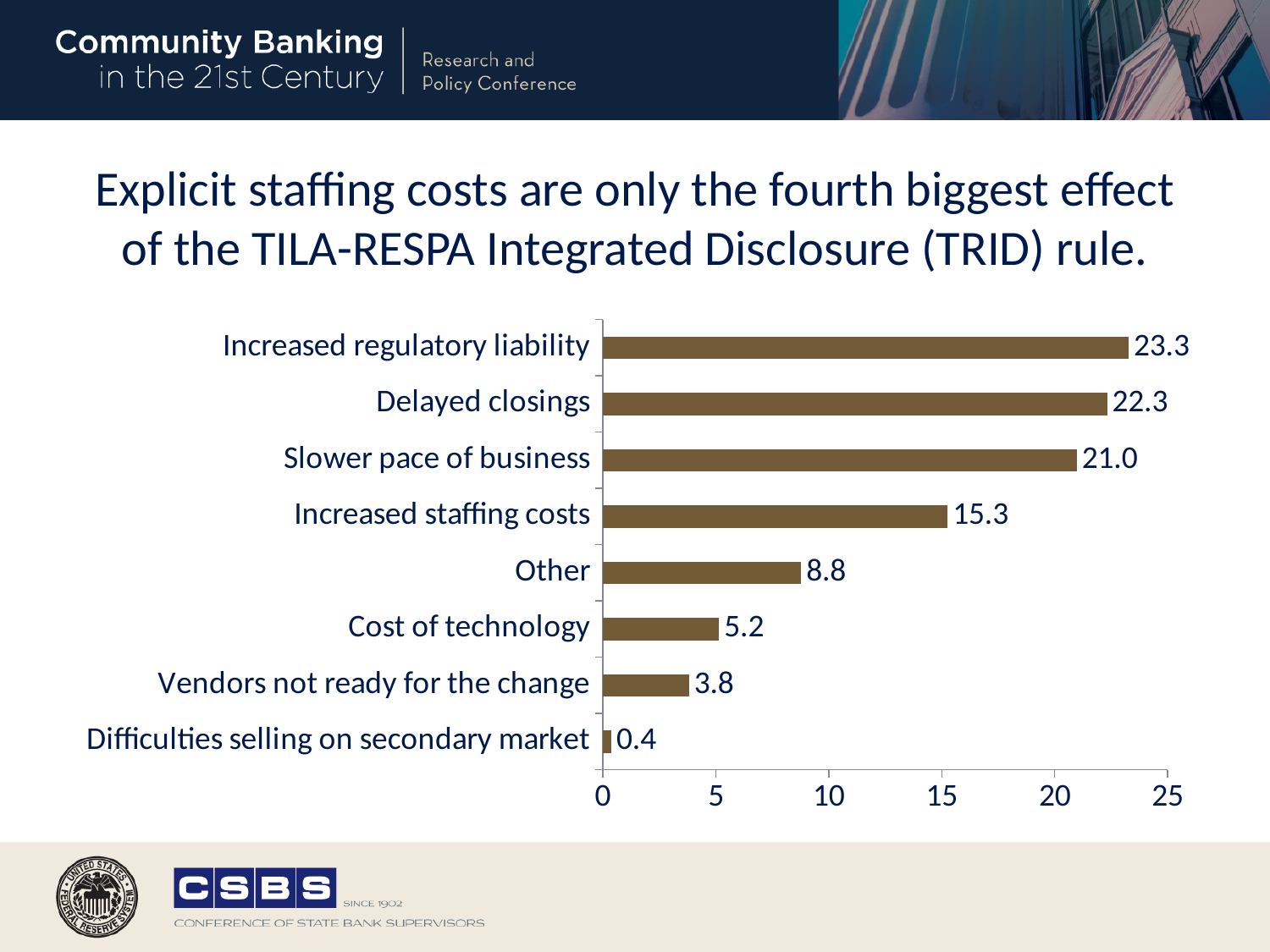
What kind of chart is shown on the slide? Bar chart What is the maximum value shown on the horizontal axis? 25 What is the value for Increased staffing costs? 15.3 How many categories are shown in the chart? 8 What is the value for Vendors not ready for the change? 3.8 What is the difference between the values for Other and Cost of technology? 3.6 Which category has the lowest value? Difficulties selling on secondary market What is the difference between the values for Delayed closings and Slower pace of business? 1.3 Which category has the highest value? Increased regulatory liability Which is larger, the value for Other or the value for Cost of technology? Other What is the value for Increased regulatory liability? 23.3 Is the value for Increased staffing costs greater or less than 15? greater